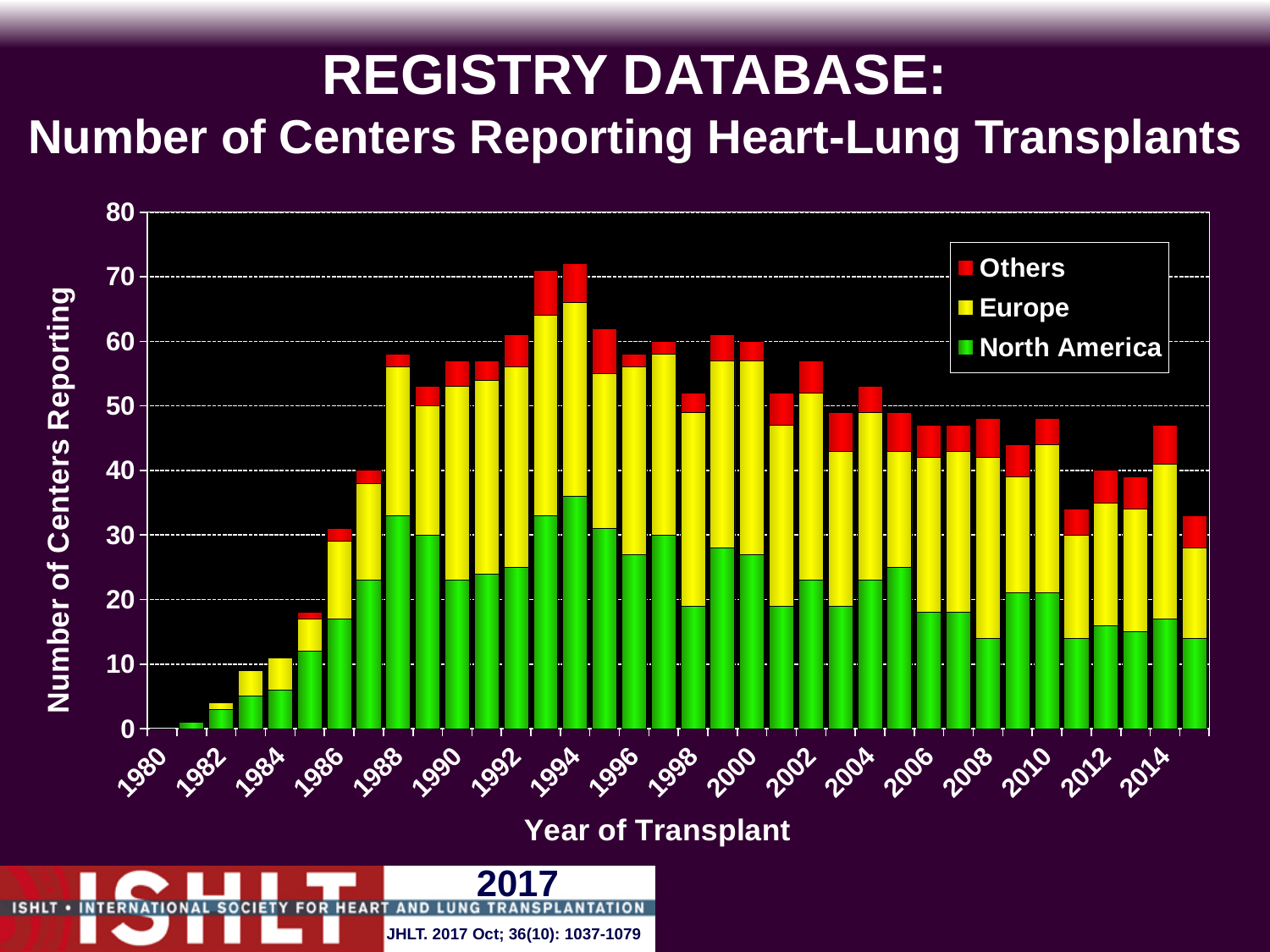
Which year has the larger total number of centers reporting, 1994 or 2015? 1994 Do the total numbers of centers reporting generally rise or fall from 1980 to 1994? rise What is the title of the vertical axis? Number of Centers Reporting Is the total number of centers reporting in 2011 greater or less than 40? less How many series does the legend list? 3 Which series is shown in green? North America How many year labels are printed along the x axis? 18 What kind of chart is shown on the slide? Stacked bar chart Is the total number of centers reporting in 1988 greater or less than 50? greater Is the total number of centers reporting in 2014 greater or less than 40? greater Which year has the larger total number of centers reporting, 1987 or 1988? 1988